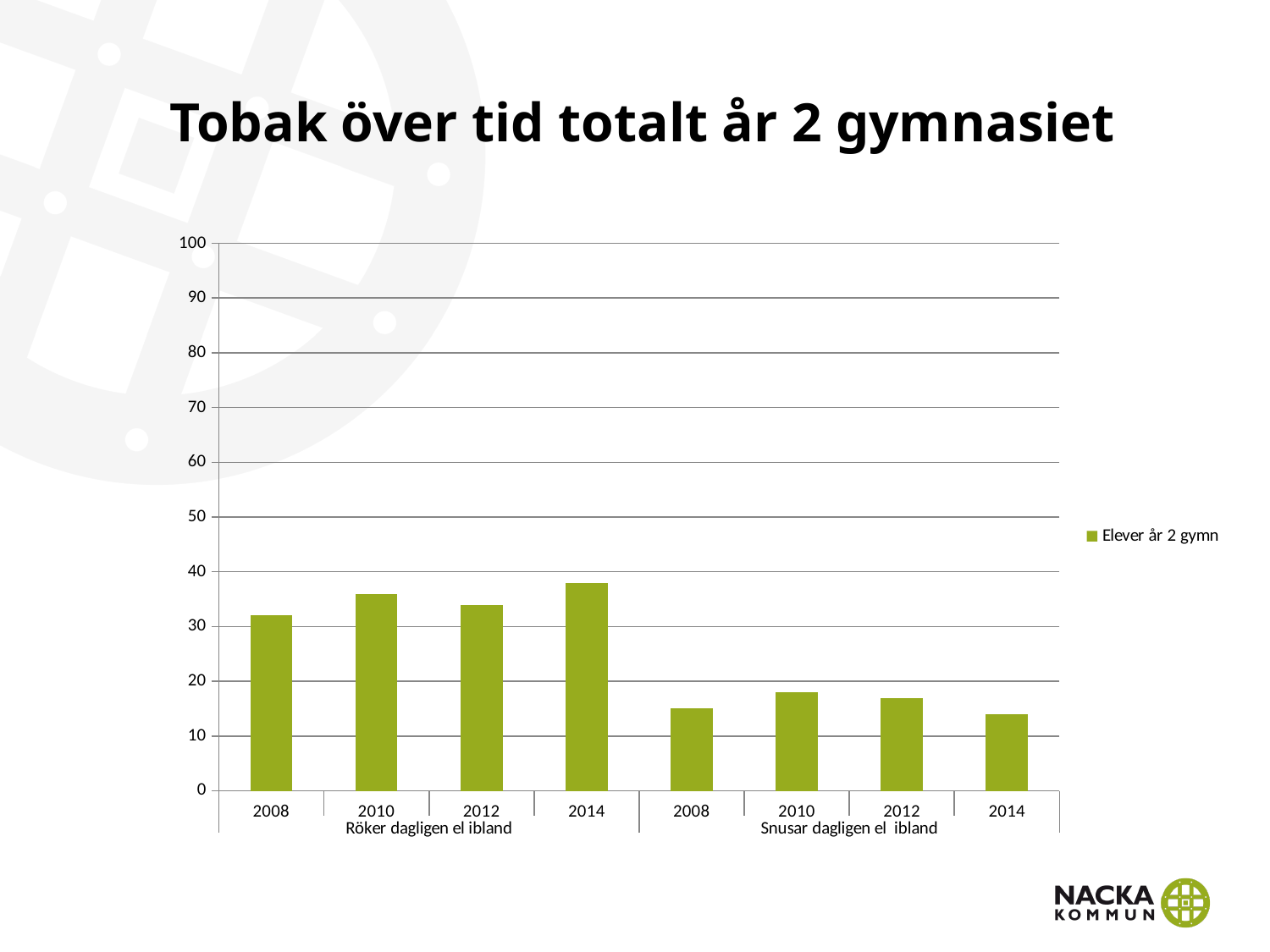
What kind of chart is shown on the slide? bar chart Is the value for 2014 under Snusar dagligen el ibland greater or less than 10? greater What is the title of the chart on the slide? Tobak över tid totalt år 2 gymnasiet Within Röker dagligen el ibland, which is larger: the value for 2008 or the value for 2010? 2010 Is the value for 2014 under Röker dagligen el ibland greater or less than 40? less Which is larger: the 2008 value for Röker dagligen el ibland or the 2008 value for Snusar dagligen el ibland? Röker dagligen el ibland How many bars are plotted in the chart? 8 Is the value for 2008 under Röker dagligen el ibland greater or less than 30? greater How many series does the legend list? 1 Which bar is the highest in the chart? 2014 (Röker dagligen el ibland) What is the legend entry for the series in the chart? Elever år 2 gymn